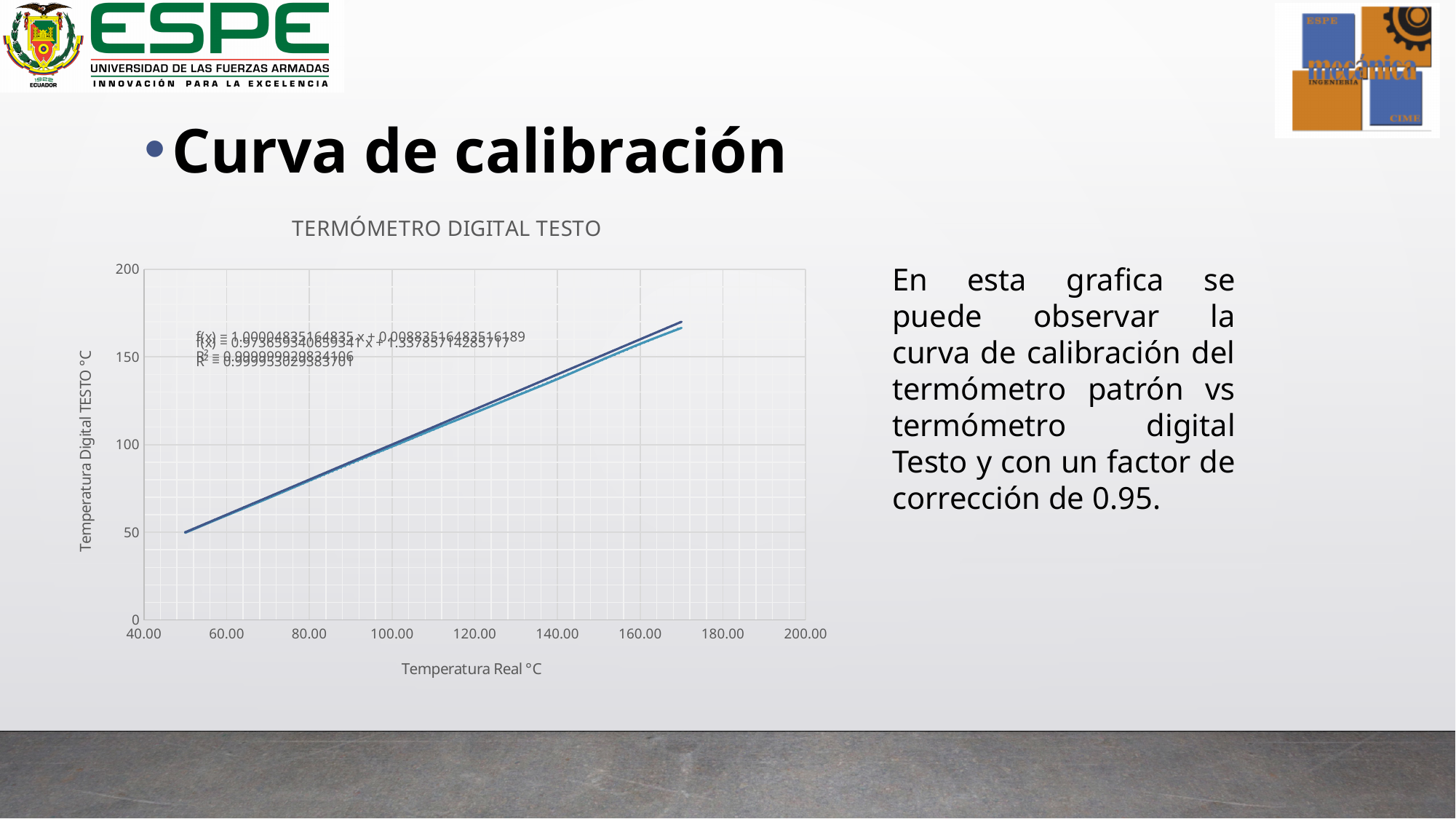
Is the plotted value at a Temperatura Real of 100.00 greater or less than 50? greater How many lines are plotted on the chart? 2 What is the title of the chart on the slide? TERMÓMETRO DIGITAL TESTO Do the plotted values rise or fall as Temperatura Real °C increases? rise What is the label of the x axis of the chart? Temperatura Real °C Is the plotted value at a Temperatura Real of 60.00 greater or less than 100? less Is the plotted value at a Temperatura Real of 170.00 greater or less than 150? greater What kind of chart is shown on the slide? line chart